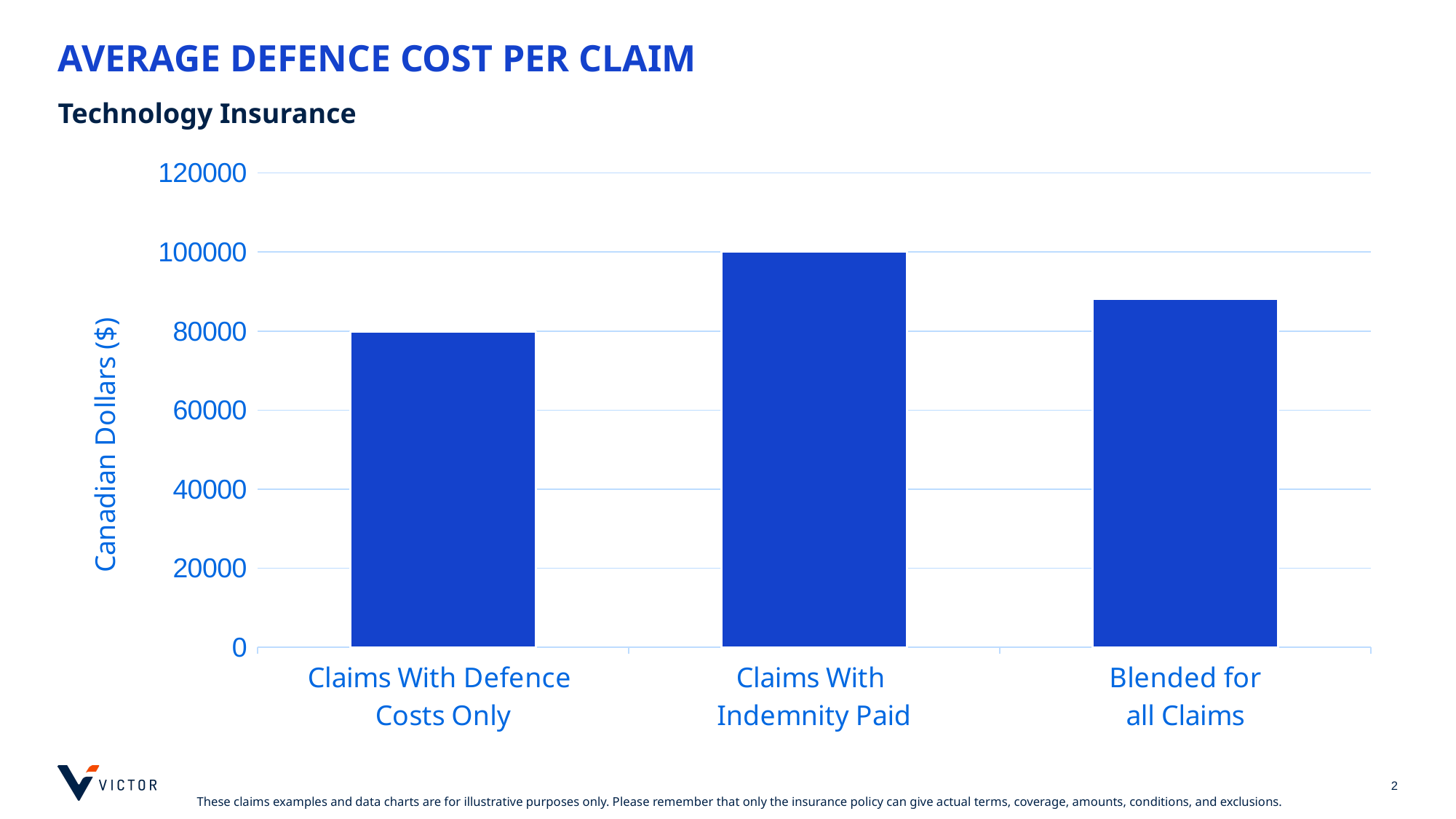
Is the value for Blended for all Claims greater or less than 80000? greater Which is larger: the value for Blended for all Claims or the value for Claims With Defence Costs Only? Blended for all Claims What kind of chart is shown on the slide? bar chart What is the title of the chart? AVERAGE DEFENCE COST PER CLAIM Which category has the highest average defence cost per claim? Claims With Indemnity Paid How many categories are shown in the chart? 3 Which category has the lowest average defence cost per claim? Claims With Defence Costs Only Is the value for Blended for all Claims greater or less than 100000? less What is the label of the vertical axis? Canadian Dollars ($)